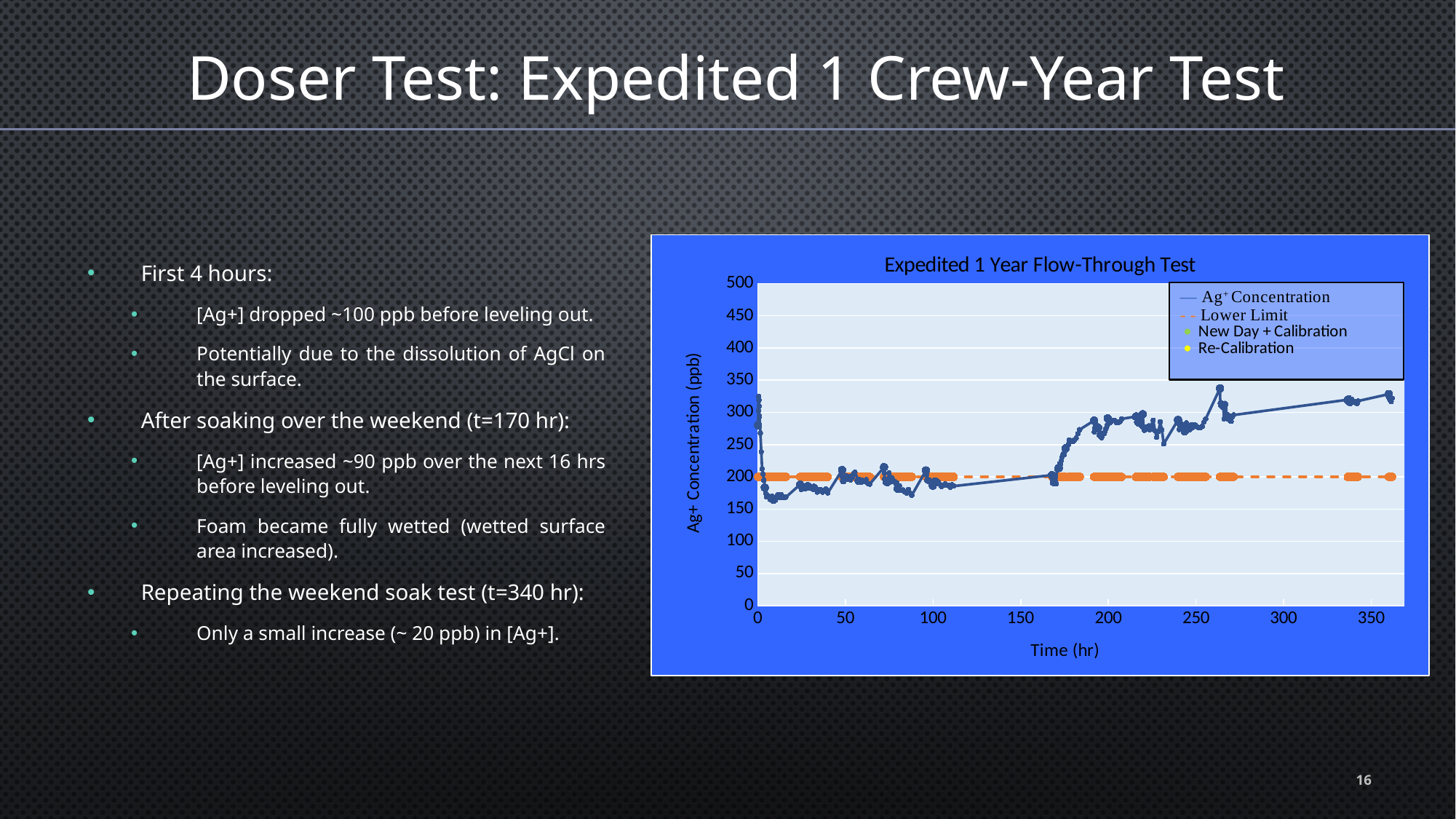
What kind of chart is shown on the slide? line chart Is the Lower Limit line greater or less than 250? less At 250 hr, which is larger: the Ag+ Concentration or the Lower Limit? Ag+ Concentration Does the Ag+ Concentration rise or fall during the first 5 hours of the test? fall Is the Ag+ Concentration at 350 hr greater or less than 300? greater Does the Ag+ Concentration rise or fall between 170 hr and 200 hr? rise How many series does the chart legend list? 4 Is the Ag+ Concentration at 50 hr greater or less than 250? less What is the label of the y axis of the chart? Ag+ Concentration (ppb) What is the title of the chart? Expedited 1 Year Flow-Through Test What is the highest value shown on the y axis of the chart? 500